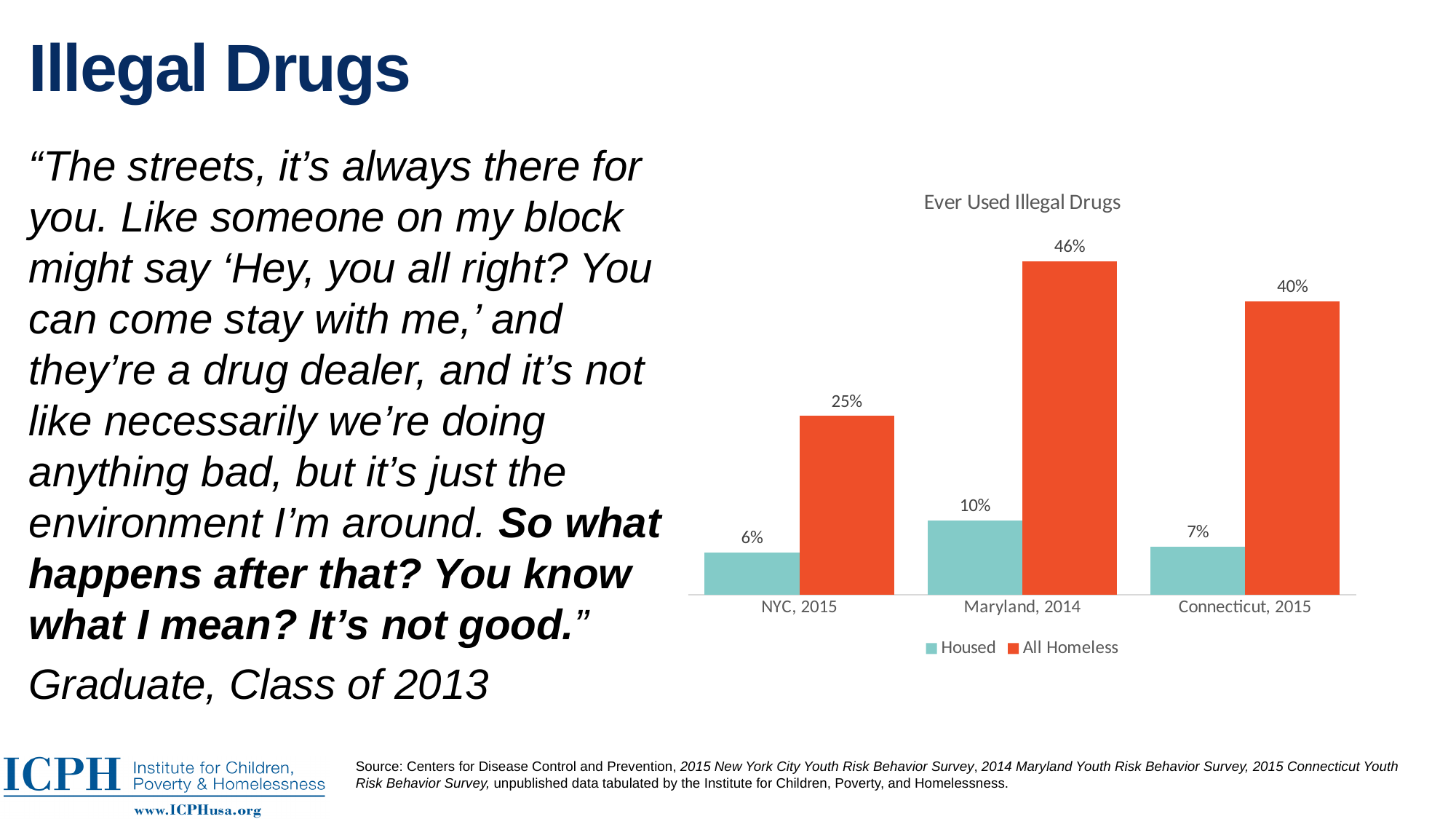
Which is larger, the Housed value for Maryland, 2014 or the Housed value for Connecticut, 2015? Maryland, 2014 How many categories are shown on the x axis? 3 What is the value for All Homeless in Maryland, 2014? 46% What is the title of the chart? Ever Used Illegal Drugs Which category has the highest All Homeless value? Maryland, 2014 What kind of chart is shown on the slide? Bar chart What is the difference between the All Homeless and Housed values for NYC, 2015? 19% How many series does the legend list? 2 What is the value for Housed in NYC, 2015? 6% What is the difference between the All Homeless values for Maryland, 2014 and Connecticut, 2015? 6% What is the value for All Homeless in Connecticut, 2015? 40% Which category has the lowest Housed value? NYC, 2015